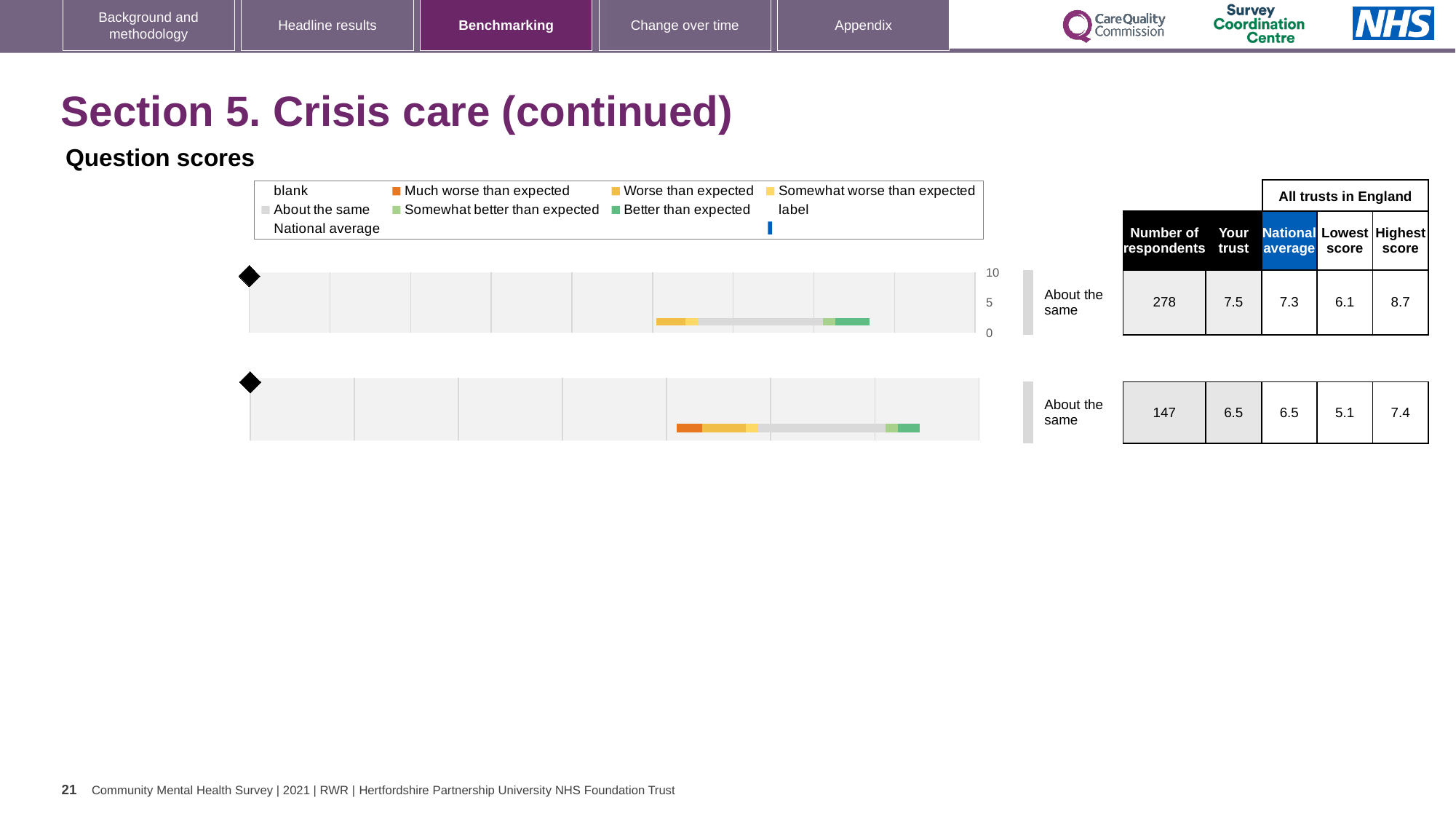
In the top chart's table, what is the national average score? 7.3 In the top chart's table, what is the 'Your trust' score? 7.5 According to the legend, which colour represents 'Much worse than expected'? Orange In the top chart's table, which is larger: the 'Your trust' score or the national average? Your trust In the bottom chart's table, what is the number of respondents? 147 In the top chart's table, what is the number of respondents? 278 In the top chart's table, what is the highest score among all trusts in England? 8.7 What kind of chart is used to show the question scores on this slide? Bar chart What is the difference in the number of respondents between the top chart and the bottom chart? 131 In the top chart's table, what is the difference between the highest score and the lowest score? 2.6 In the bottom chart's table, what is the lowest score among all trusts in England? 5.1 In the bottom chart's table, what is the 'Your trust' score? 6.5